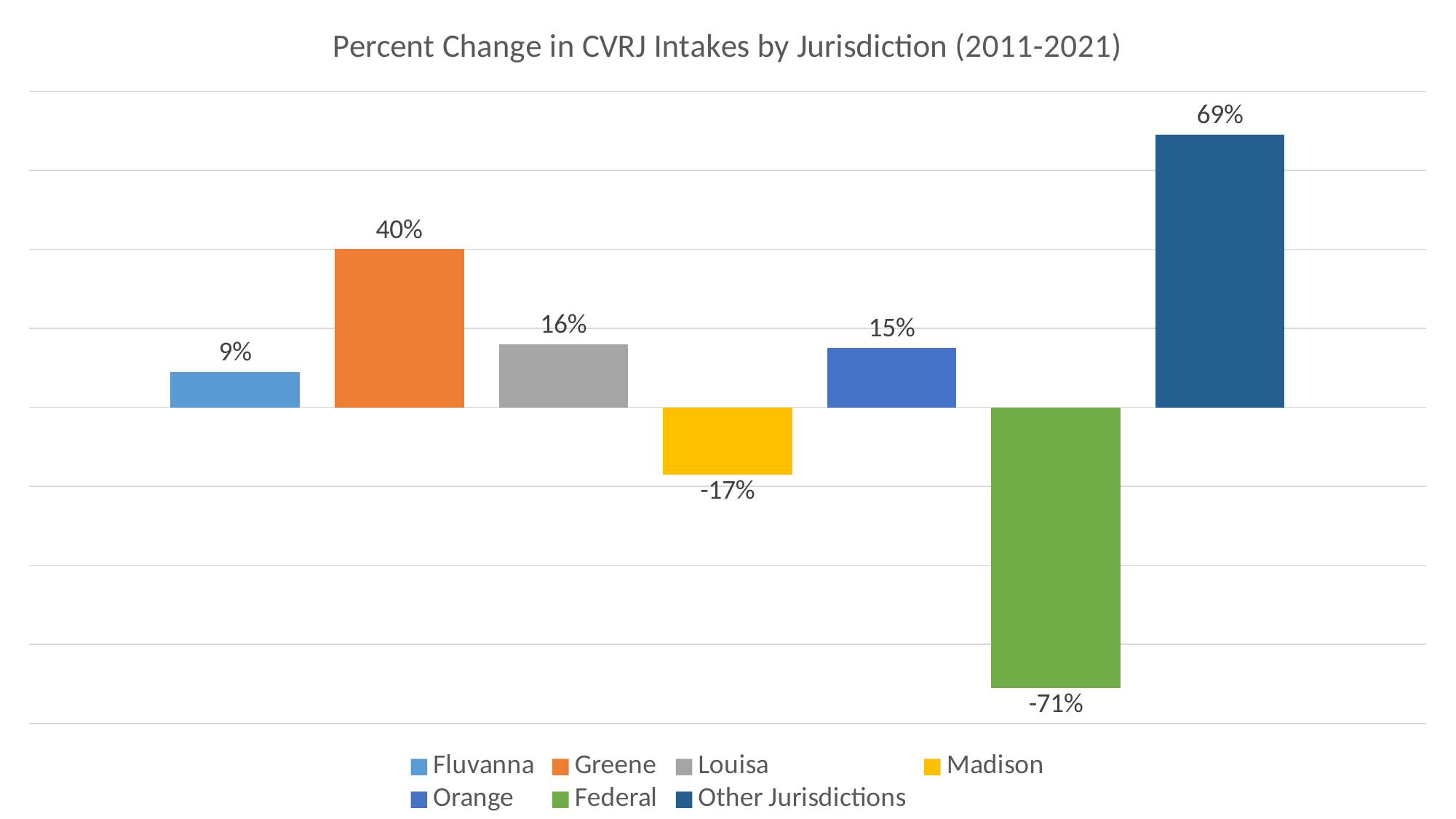
How many jurisdictions are shown in the chart? 7 What is the title of the chart? Percent Change in CVRJ Intakes by Jurisdiction (2011-2021) What is the percent change in CVRJ intakes for Fluvanna? 9% Which has a larger percent change in CVRJ intakes, Louisa or Fluvanna? Louisa What is the difference between the percent change for Other Jurisdictions and Greene? 29% Which jurisdiction has the lowest percent change in CVRJ intakes? Federal What is the percent change in CVRJ intakes for Madison? -17% What type of chart is shown on the slide? Bar chart What is the percent change in CVRJ intakes for Greene? 40% What colour is the bar for Madison? Yellow Which jurisdiction has the highest percent change in CVRJ intakes? Other Jurisdictions What is the percent change in CVRJ intakes for Federal? -71%